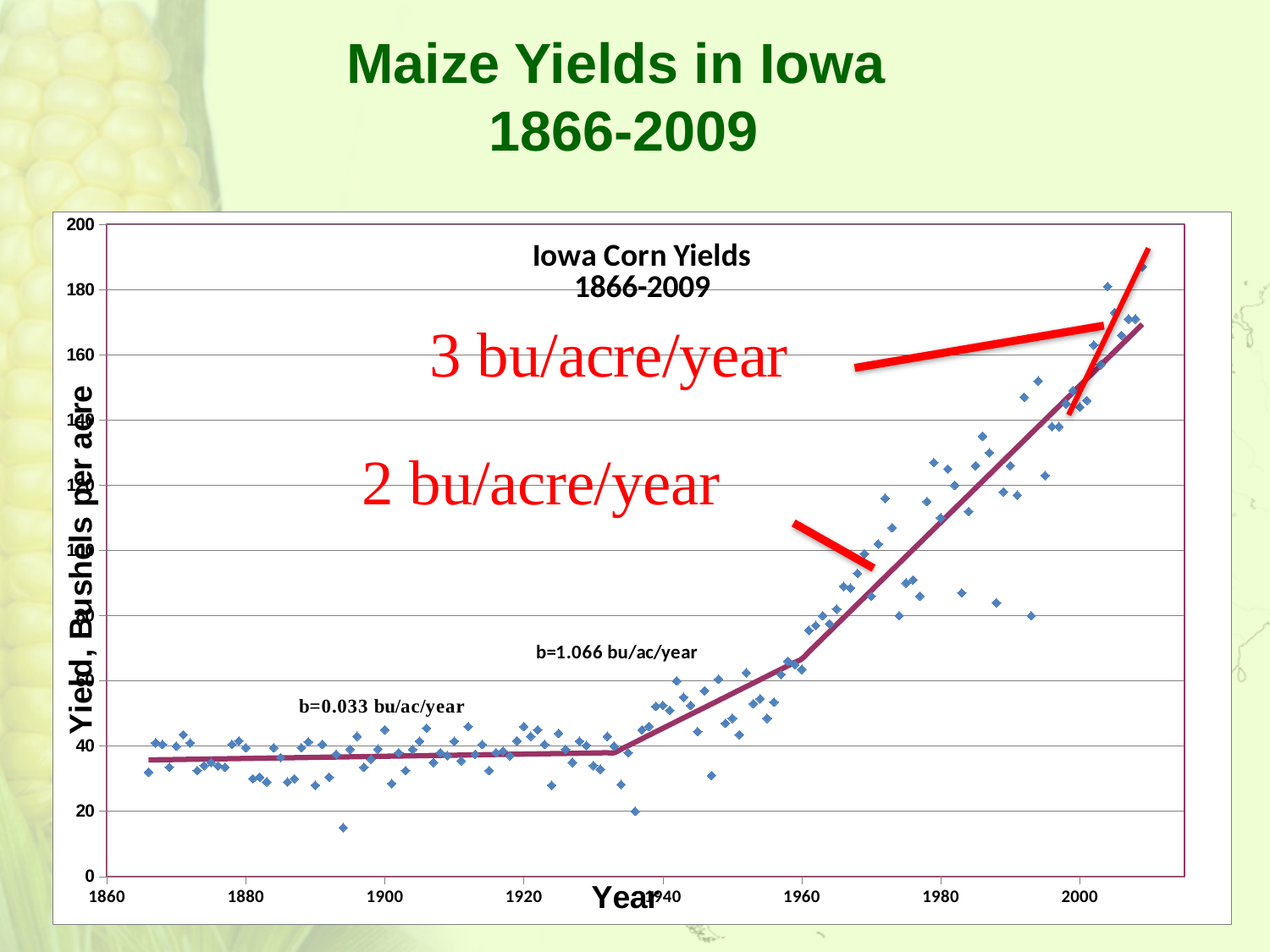
Is the lowest plotted yield, around 1894, greater or less than 20 bushels per acre? less What is the label of the vertical axis? Yield, Bushels per acre Is the yield for 2009 greater or less than 160 bushels per acre? greater Are yields in the 2000s higher or lower than yields in the 1880s? Higher What kind of chart is shown on the slide? Scatter chart What rate of yield increase is annotated in red for the period after about 1960? 2 bu/acre/year What is the highest value shown on the vertical axis? 200 What slope (b) is printed for the middle segment of the trend line, around 1940-1960? b=1.066 bu/ac/year What is the title printed inside the chart area? Iowa Corn Yields 1866-2009 Do Iowa corn yields generally rise or fall from 1866 to 2009? Rise What slope (b) is printed for the early, flat segment of the trend line? b=0.033 bu/ac/year What rate of yield increase is annotated in red for the most recent years? 3 bu/acre/year